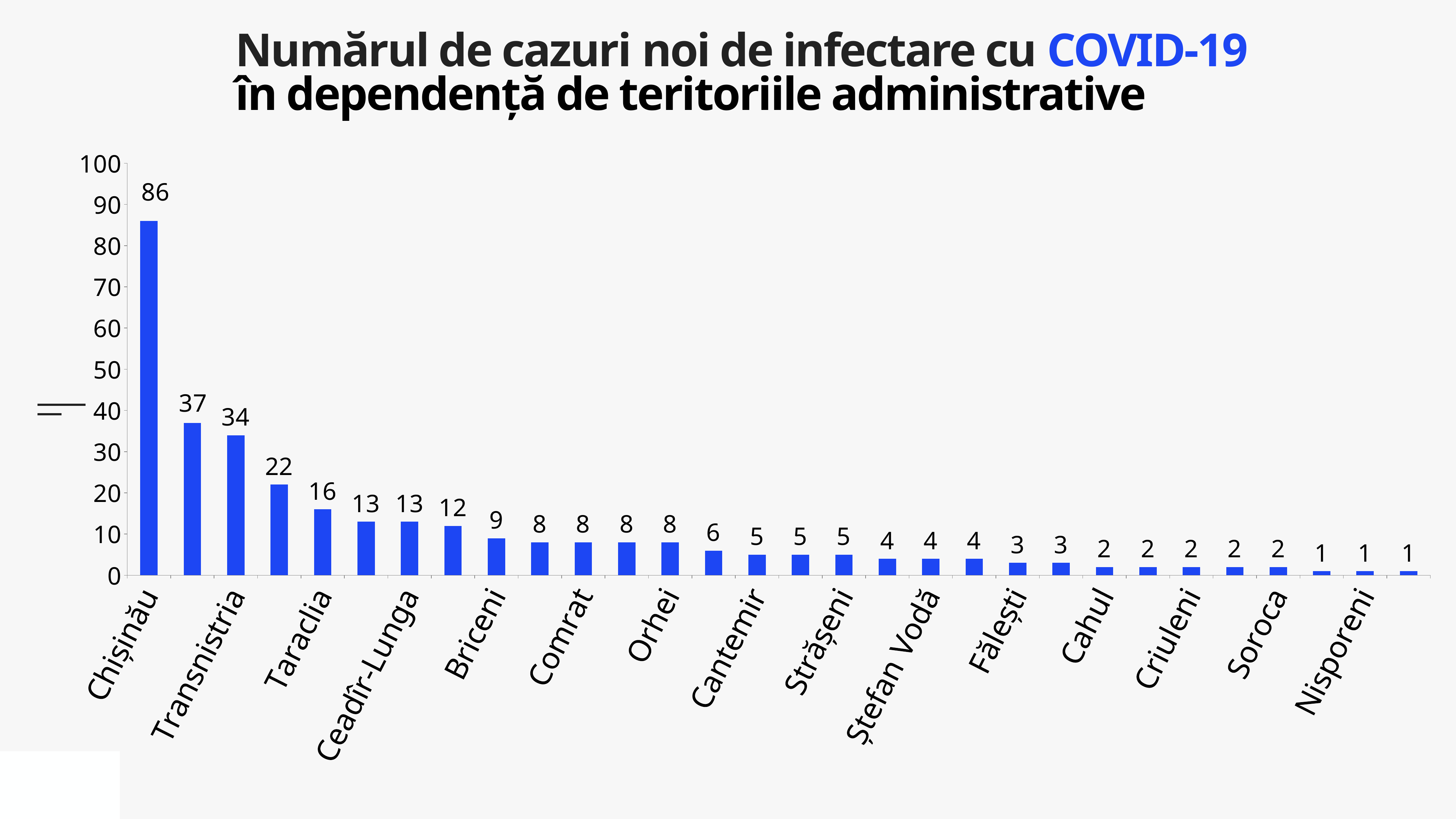
Which administrative territory has the highest number of new cases? Chișinău What is the number of new cases for Cantemir? 5 What is the number of new cases for Nisporeni? 1 Which has more new cases, Chișinău or Cahul? Chișinău What is the number of new cases for Comrat? 8 Is the value for Chișinău greater or less than 80? greater Do the values rise or fall from left to right along the x axis? Fall What is the number of new COVID-19 cases for Chișinău? 86 What kind of chart is shown on the slide? Bar chart What is the number of new cases for Fălești? 3 What is the difference between the highest bar (86) and the second highest bar (37)? 49 How many bars are plotted in the chart? 30